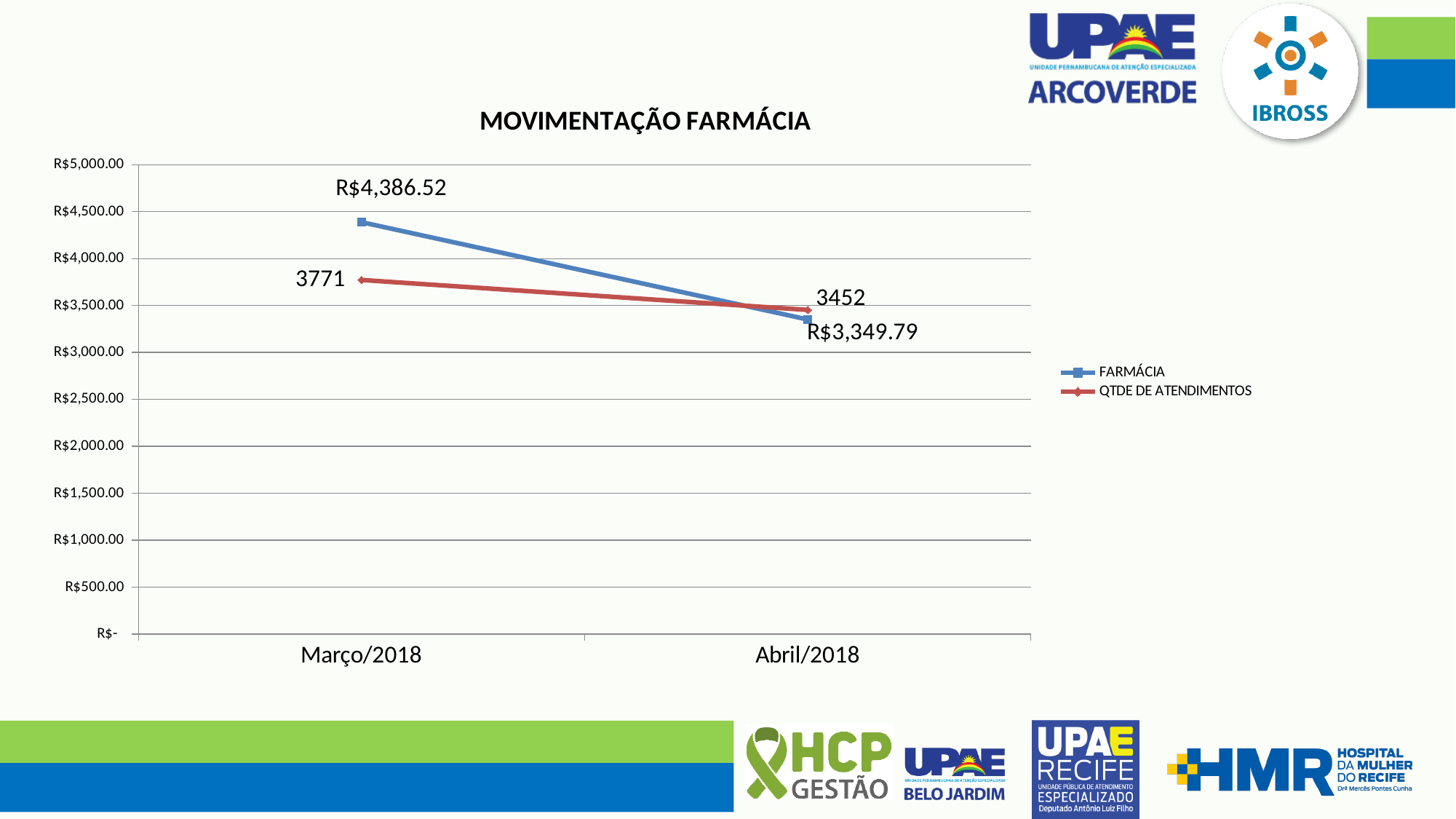
What is the value of the FARMÁCIA series for Março/2018? R$4,386.52 In Abril/2018, which series has the higher value, FARMÁCIA or QTDE DE ATENDIMENTOS? QTDE DE ATENDIMENTOS Does the FARMÁCIA series rise or fall from Março/2018 to Abril/2018? fall What type of chart is shown on the slide? line chart What is the value of the FARMÁCIA series for Abril/2018? R$3,349.79 What is the difference in QTDE DE ATENDIMENTOS between Março/2018 and Abril/2018? 319 By how much did the FARMÁCIA value decrease from Março/2018 to Abril/2018? R$1,036.73 How many categories are shown on the x axis? 2 How many series does the legend list? 2 What is the value of QTDE DE ATENDIMENTOS for Abril/2018? 3452 What is the value of QTDE DE ATENDIMENTOS for Março/2018? 3771 In Março/2018, which series has the higher value, FARMÁCIA or QTDE DE ATENDIMENTOS? FARMÁCIA